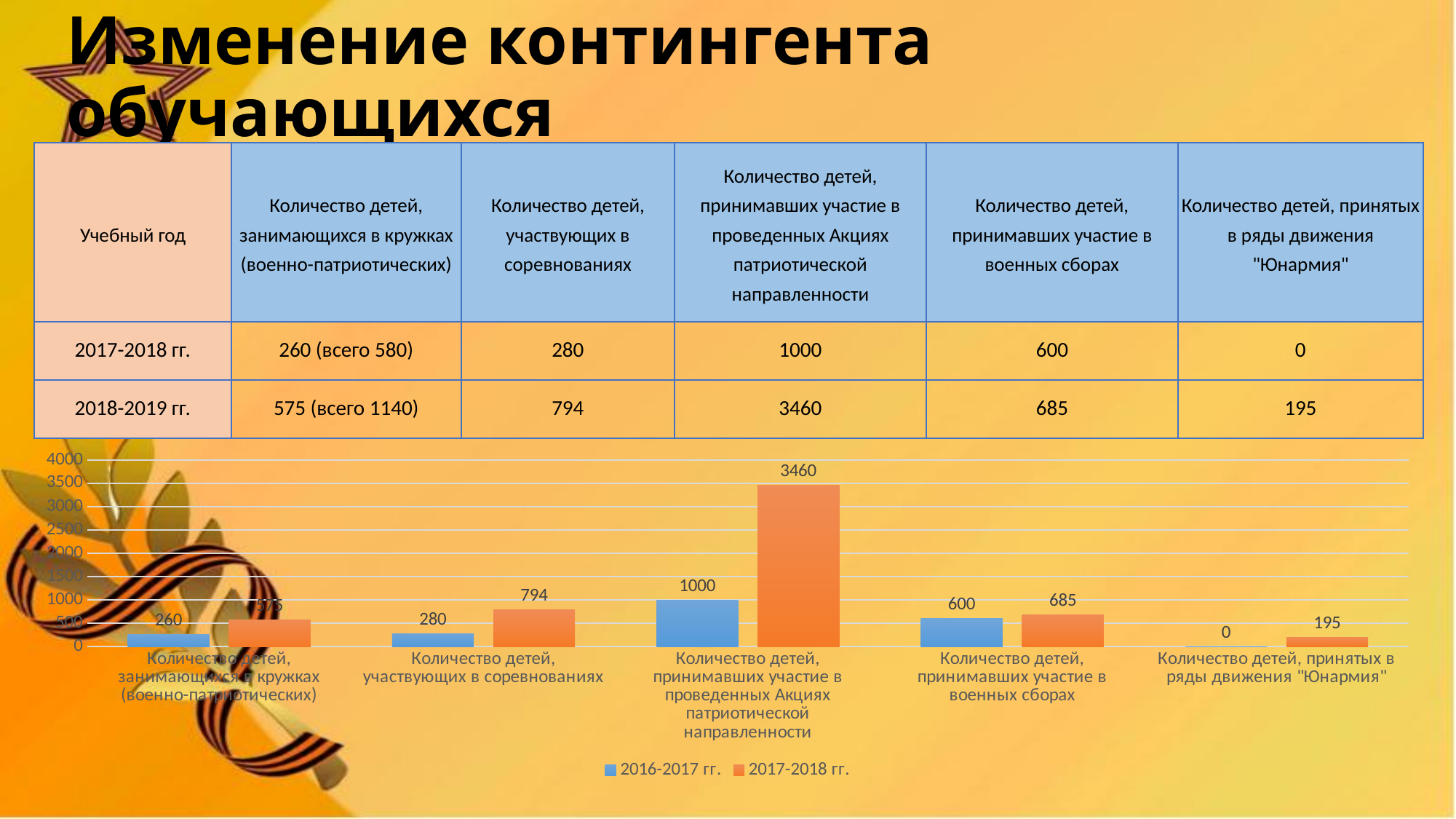
How many series does the chart legend list? 2 Which category has the lowest value for the 2016-2017 гг. series? Количество детей, принятых в ряды движения "Юнармия" What is the value for the 2016-2017 гг. series in the category 'Количество детей, участвующих в соревнованиях'? 280 What is the value for the 2017-2018 гг. series in the category 'Количество детей, принимавших участие в проведенных Акциях патриотической направленности'? 3460 What is the value for the 2017-2018 гг. series in the category 'Количество детей, принятых в ряды движения "Юнармия"'? 195 What type of chart is shown on the slide? bar chart What colour are the bars for the 2016-2017 гг. series? blue How many categories are shown on the x axis of the chart? 5 What is the difference between the 2017-2018 гг. and 2016-2017 гг. values for 'Количество детей, участвующих в соревнованиях'? 514 Is the 2017-2018 гг. value for 'Количество детей, принимавших участие в проведенных Акциях патриотической направленности' greater or less than 3000? greater Which is larger in the category 'Количество детей, принимавших участие в военных сборах': the 2016-2017 гг. value or the 2017-2018 гг. value? 2017-2018 гг. Which category has the highest value for the 2017-2018 гг. series? Количество детей, принимавших участие в проведенных Акциях патриотической направленности